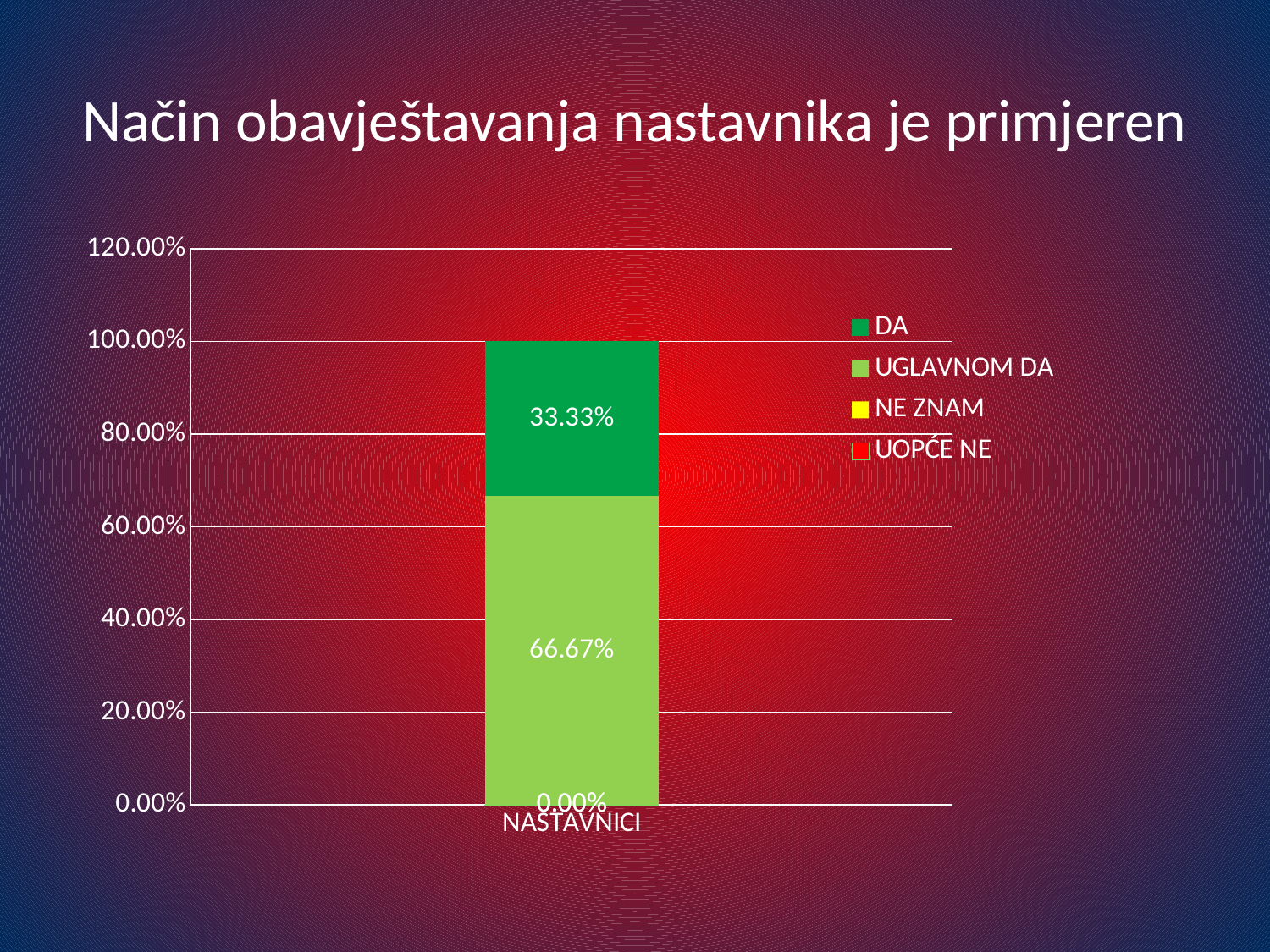
What is the total of the stacked NASTAVNICI bar? 100.00% What is the difference between the UGLAVNOM DA and DA values for NASTAVNICI? 33.34% Which is larger for NASTAVNICI, DA or UGLAVNOM DA? UGLAVNOM DA Which series has the largest share of the NASTAVNICI bar? UGLAVNOM DA What is the title of the slide? Način obavještavanja nastavnika je primjeren What is the value for DA in the NASTAVNICI bar? 33.33% How many categories are shown on the x axis? 1 What is the value for UGLAVNOM DA in the NASTAVNICI bar? 66.67% Is the value for DA greater or less than 40%? less What is the label of the category on the x axis? NASTAVNICI How many series does the legend list? 4 What kind of chart is shown on the slide? stacked bar chart